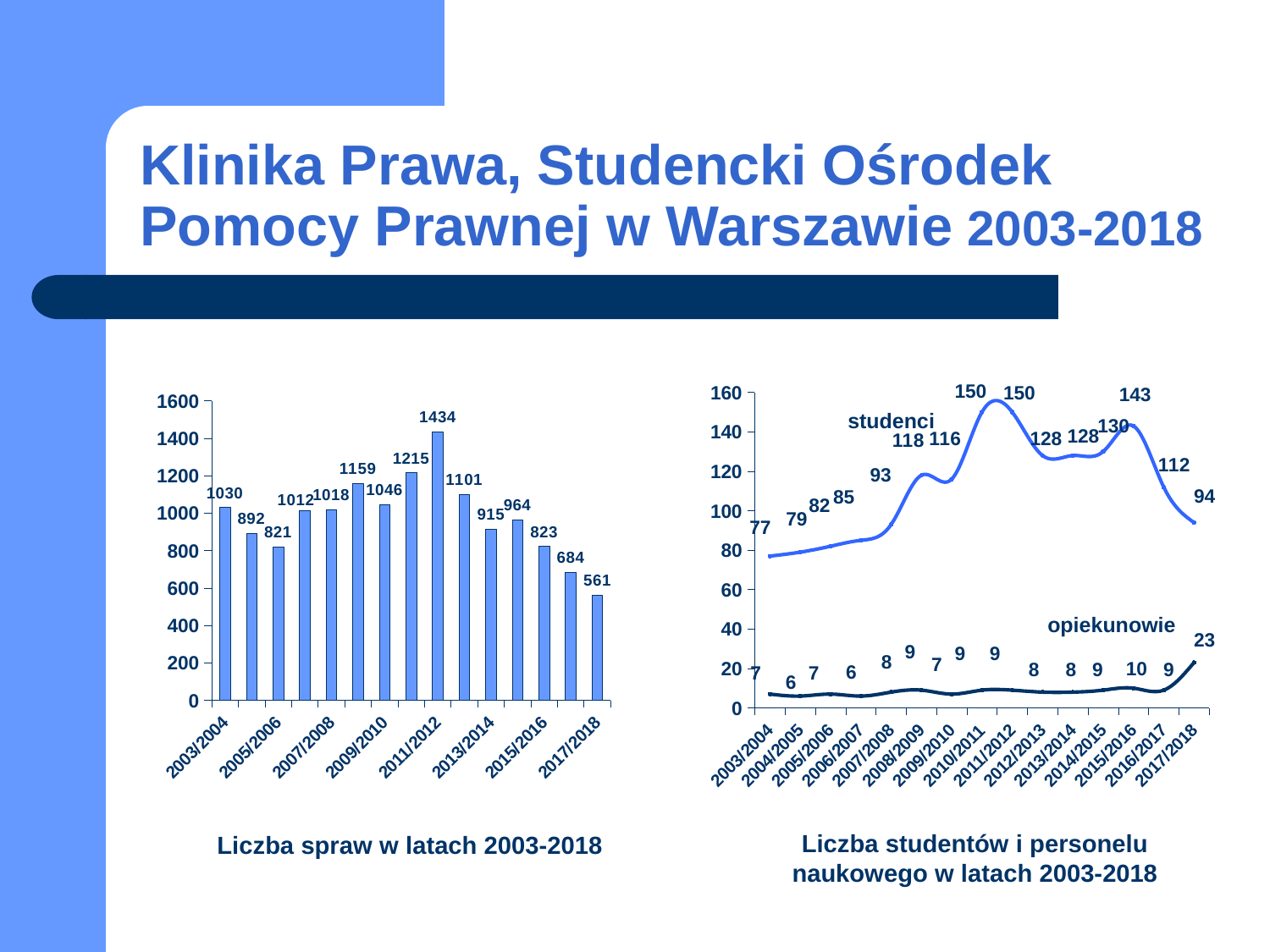
In the chart 'Liczba spraw w latach 2003-2018', which year has the lowest value? 2017/2018 In the chart 'Liczba spraw w latach 2003-2018', how many bars are plotted? 15 In the chart 'Liczba studentów i personelu naukowego w latach 2003-2018', does the studenci series rise or fall from 2003/2004 to 2010/2011? rise In the chart 'Liczba spraw w latach 2003-2018', which is larger: the value for 2003/2004 or the value for 2009/2010? 2009/2010 In the chart 'Liczba studentów i personelu naukowego w latach 2003-2018', how many series are plotted? 2 In the chart 'Liczba studentów i personelu naukowego w latach 2003-2018', what is the difference between studenci and opiekunowie in 2017/2018? 71 In the chart 'Liczba studentów i personelu naukowego w latach 2003-2018', what is the value for opiekunowie in 2017/2018? 23 What kind of chart is 'Liczba spraw w latach 2003-2018'? bar chart In the chart 'Liczba studentów i personelu naukowego w latach 2003-2018', what is the value for studenci in 2015/2016? 143 In the chart 'Liczba spraw w latach 2003-2018', what is the difference between the values for 2011/2012 and 2017/2018? 873 In the chart 'Liczba spraw w latach 2003-2018', what is the value for 2017/2018? 561 In the chart 'Liczba spraw w latach 2003-2018', what is the value for 2011/2012? 1434